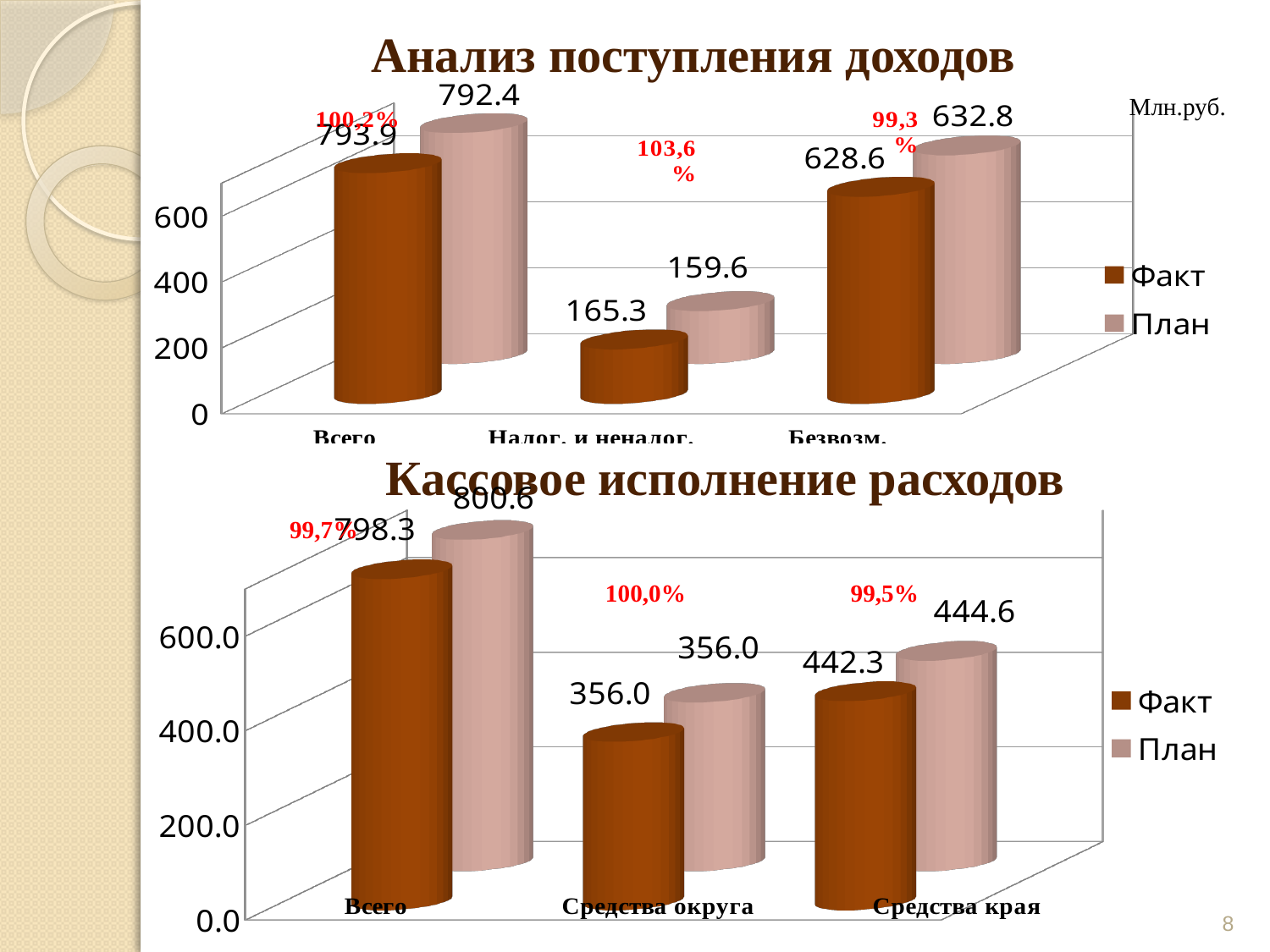
In the chart 'Кассовое исполнение расходов', which category has the highest План value? Всего In the chart 'Анализ поступления доходов', how many series does the legend list? 2 In the chart 'Кассовое исполнение расходов', how many categories are shown on the x axis? 3 In the chart 'Анализ поступления доходов', what is the Факт value for Всего? 793.9 In the chart 'Анализ поступления доходов', what is the difference between the Факт and План values for Налог. и неналог.? 5.7 What kind of chart is 'Кассовое исполнение расходов'? Bar chart In the chart 'Кассовое исполнение расходов', what is the difference between the План and Факт values for Средства края? 2.3 In the chart 'Кассовое исполнение расходов', what is the Факт value for Средства края? 442.3 In the chart 'Анализ поступления доходов', what is the План value for Безвозм.? 632.8 In the chart 'Анализ поступления доходов', what is the План value for Налог. и неналог.? 159.6 In the chart 'Кассовое исполнение расходов', what is the План value for Всего? 800.6 In the chart 'Анализ поступления доходов', which category has the lowest Факт value? Налог. и неналог.